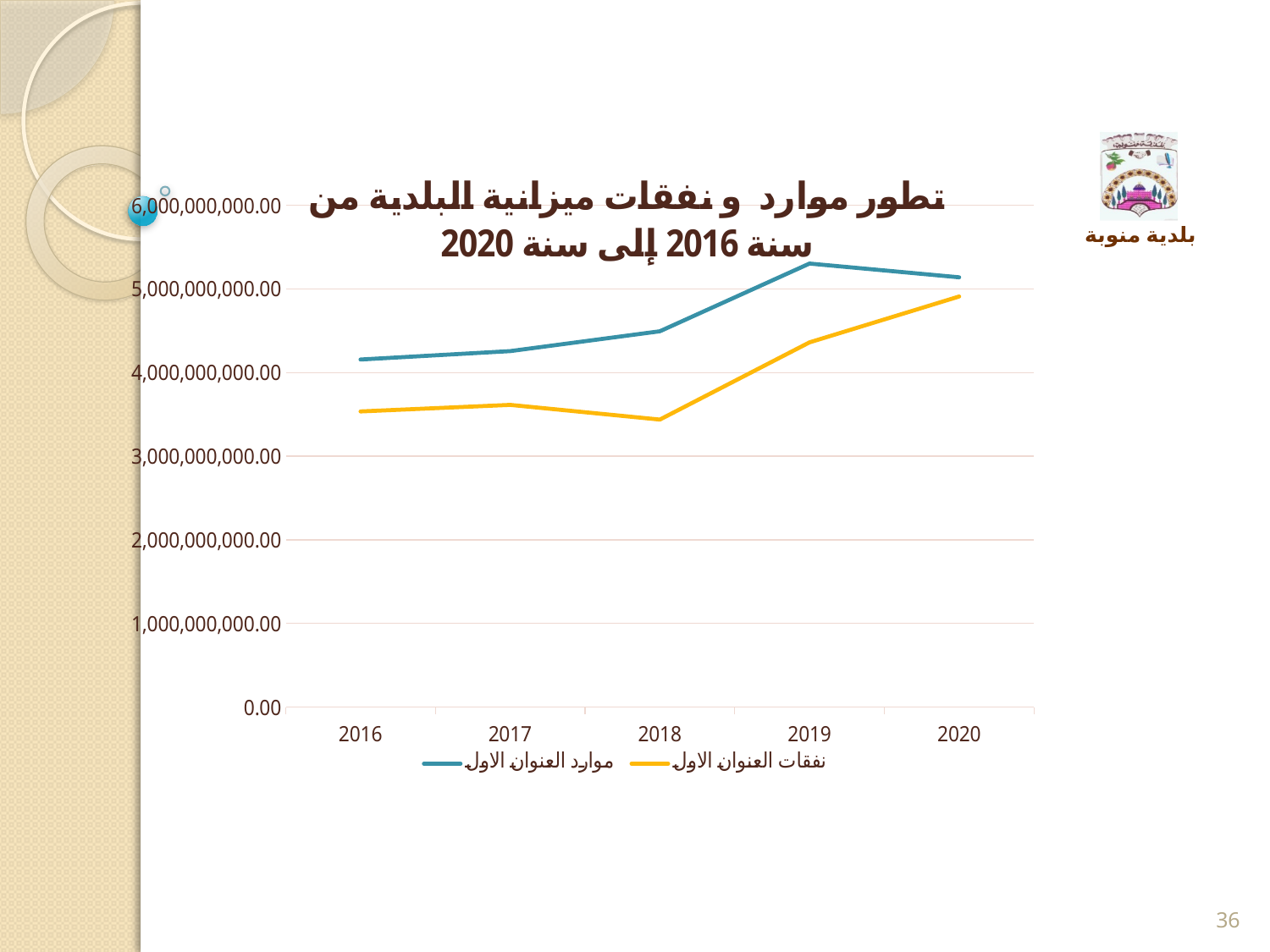
How many series does the legend list? 2 In which year is the value for نفقات العنوان الاول highest? 2020 Does the value for نفقات العنوان الاول rise or fall from 2018 to 2020? rise Is the value for نفقات العنوان الاول in 2018 greater or less than 4,000,000,000.00? less In 2020, which series has the larger value, موارد العنوان الاول or نفقات العنوان الاول? موارد العنوان الاول What kind of chart is shown on the slide? line chart In which year is the value for موارد العنوان الاول highest? 2019 Is the value for موارد العنوان الاول in 2019 greater or less than 5,000,000,000.00? greater How many years are plotted along the x axis? 5 Which colour is the line for نفقات العنوان الاول? yellow Is the value for موارد العنوان الاول in 2016 greater or less than 4,000,000,000.00? greater In which year is the value for موارد العنوان الاول lowest? 2016